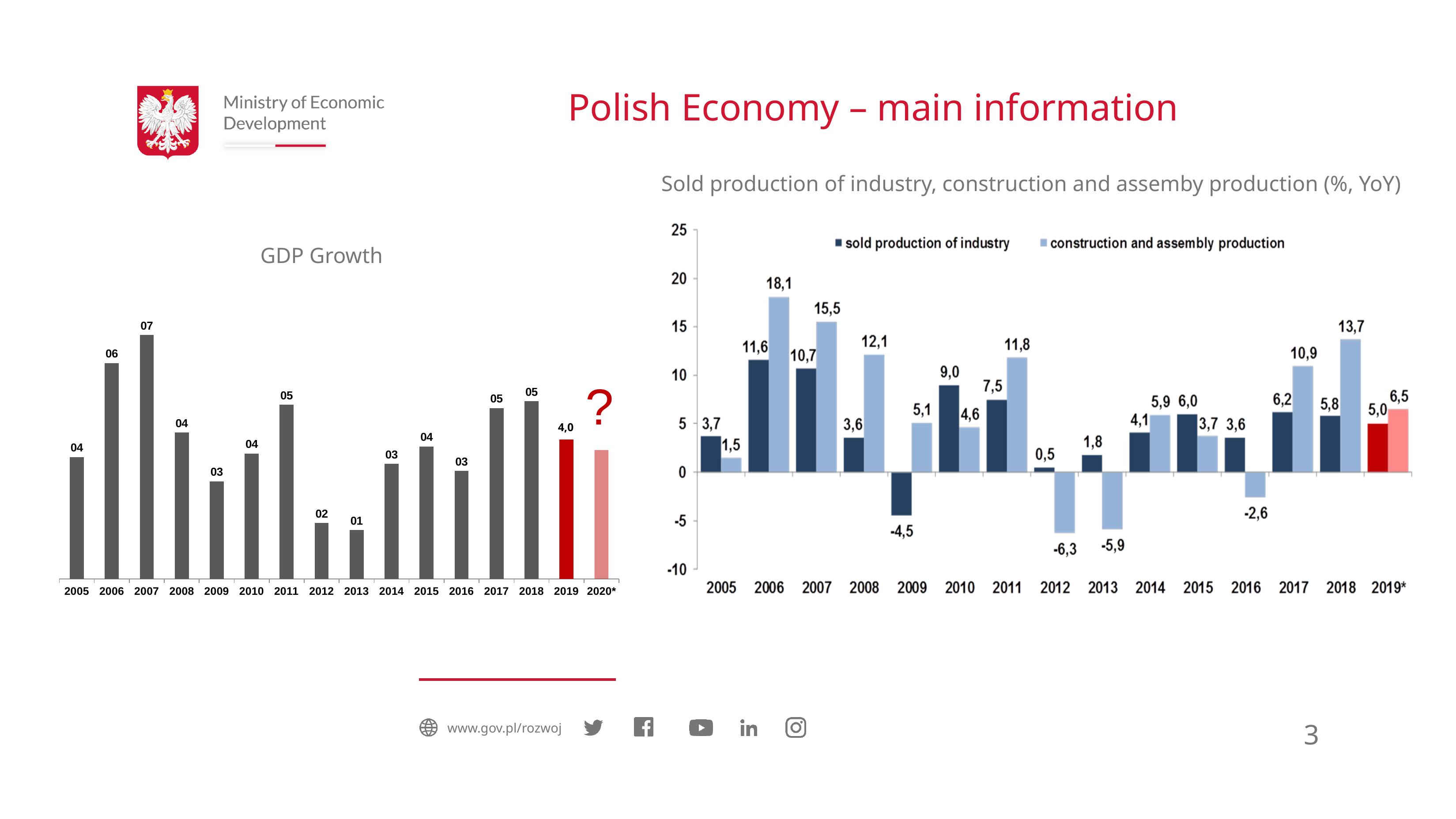
In the 'Sold production of industry, construction and assemby production' chart, how much higher is construction and assembly production than sold production of industry in 2007? 4,8 In the 'GDP Growth' chart, which year has the highest bar? 2007 In the 'Sold production of industry, construction and assemby production' chart, which year has the highest construction and assembly production value? 2006 What kind of chart is the 'GDP Growth' chart? bar chart In the 'GDP Growth' chart, which year has the lowest bar? 2013 In the 'GDP Growth' chart, what is the value labelled for 2019? 4,0 How many years are shown on the x axis of the 'Sold production of industry, construction and assemby production' chart? 15 In the 'Sold production of industry, construction and assemby production' chart, which series has the larger value in 2015? sold production of industry In the 'Sold production of industry, construction and assemby production' chart, what is the value of sold production of industry in 2006? 11,6 In the 'Sold production of industry, construction and assemby production' chart, what is the value of construction and assembly production in 2018? 13,7 How many series does the legend of the 'Sold production of industry, construction and assemby production' chart list? 2 In the 'Sold production of industry, construction and assemby production' chart, which year has the lowest construction and assembly production value? 2012